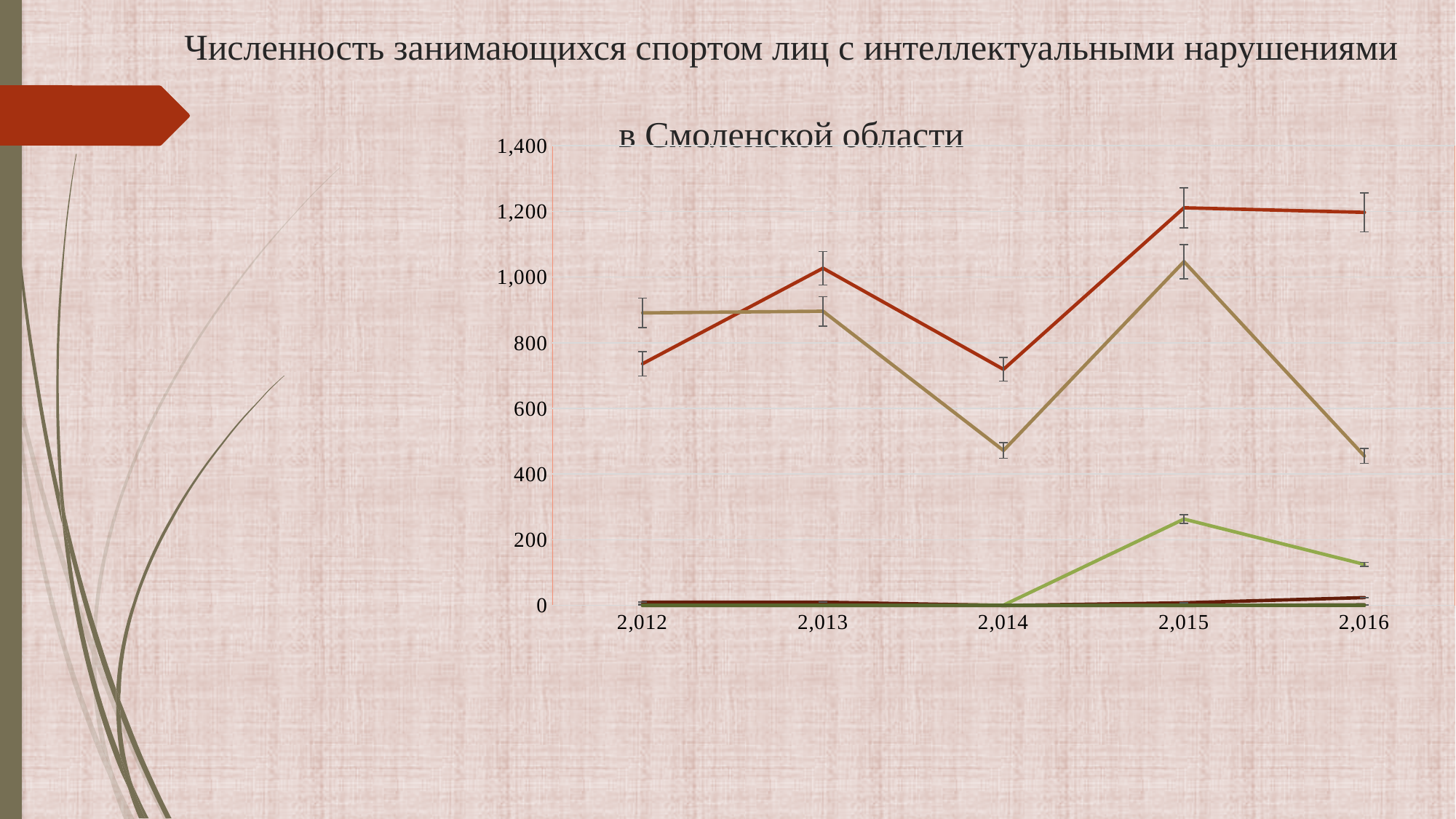
What is the first year shown on the x axis? 2,012 In which year does the light green line reach its highest value? 2,015 Is the value of the red line for 2,012 greater or less than 800? less What is the highest value shown on the y axis? 1,400 How many years are plotted along the x axis? 5 Is the value of the tan (light brown) line for 2,014 greater or less than 600? less Does the tan (light brown) line rise or fall from 2,015 to 2,016? fall Is the value of the light green line for 2,015 greater or less than 200? greater For 2,014, which line has the larger value, the red line or the tan (light brown) line? the red line In which year does the tan (light brown) line reach its highest value? 2,015 What kind of chart is shown on the slide? line chart